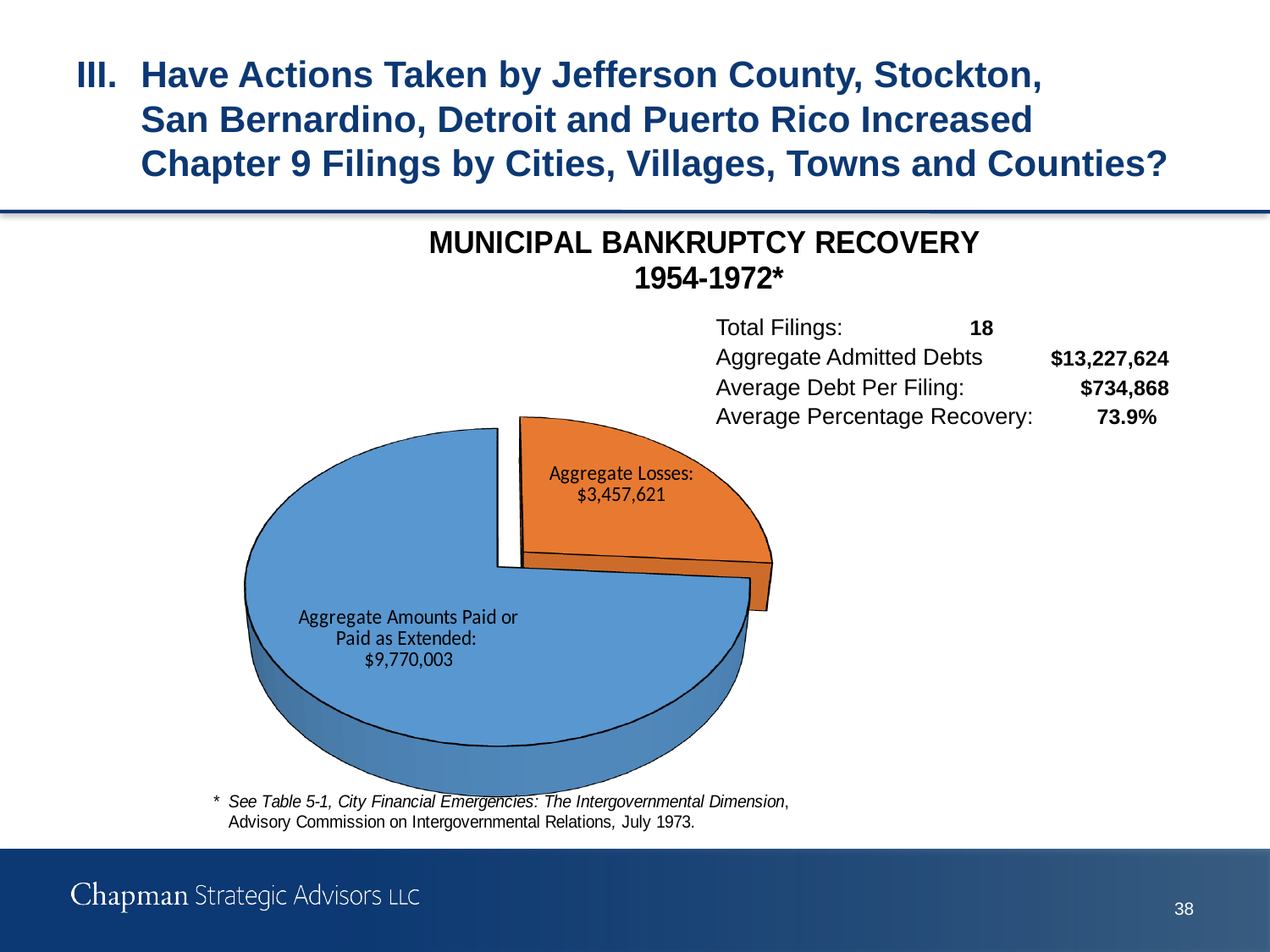
What kind of chart is shown on the slide? Pie chart How many slices does the pie chart have? 2 What is the value of the Aggregate Losses slice? $3,457,621 What share of the pie does the Aggregate Amounts Paid or Paid as Extended slice represent? 73.9% What is the value of the Aggregate Amounts Paid or Paid as Extended slice? $9,770,003 What is the difference between Aggregate Amounts Paid or Paid as Extended and Aggregate Losses? $6,312,382 What is the total of the two slices in the pie chart? $13,227,624 Which slice of the pie is the smallest? Aggregate Losses Which is larger, Aggregate Losses or Aggregate Amounts Paid or Paid as Extended? Aggregate Amounts Paid or Paid as Extended What is the title of the chart? MUNICIPAL BANKRUPTCY RECOVERY 1954-1972* Which slice of the pie is the largest? Aggregate Amounts Paid or Paid as Extended What colour is the Aggregate Losses slice? Orange